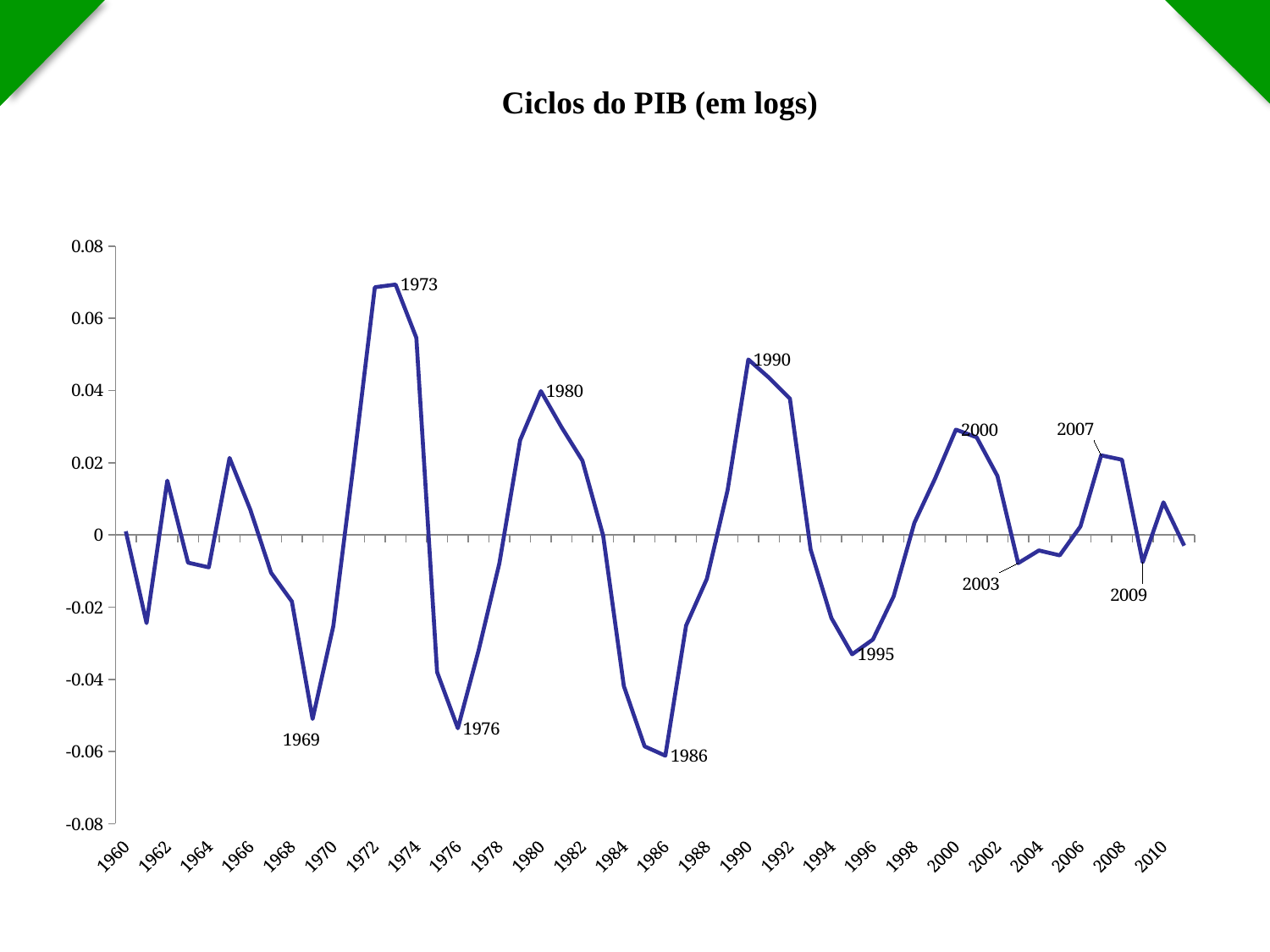
Which has the larger value, 1973 or 1990? 1973 Does the line rise or fall between 1969 and 1973? rise Is the value for 1995 greater or less than -0.02? less Which labelled year has the highest value on the chart? 1973 Is the value for 2003 greater or less than 0? less What kind of chart is shown on the slide? line chart Is the value for 1973 greater or less than 0.06? greater What is the title of the chart? Ciclos do PIB (em logs) How many years are annotated with labels on the line? 11 Which labelled year has the lowest value on the chart? 1986